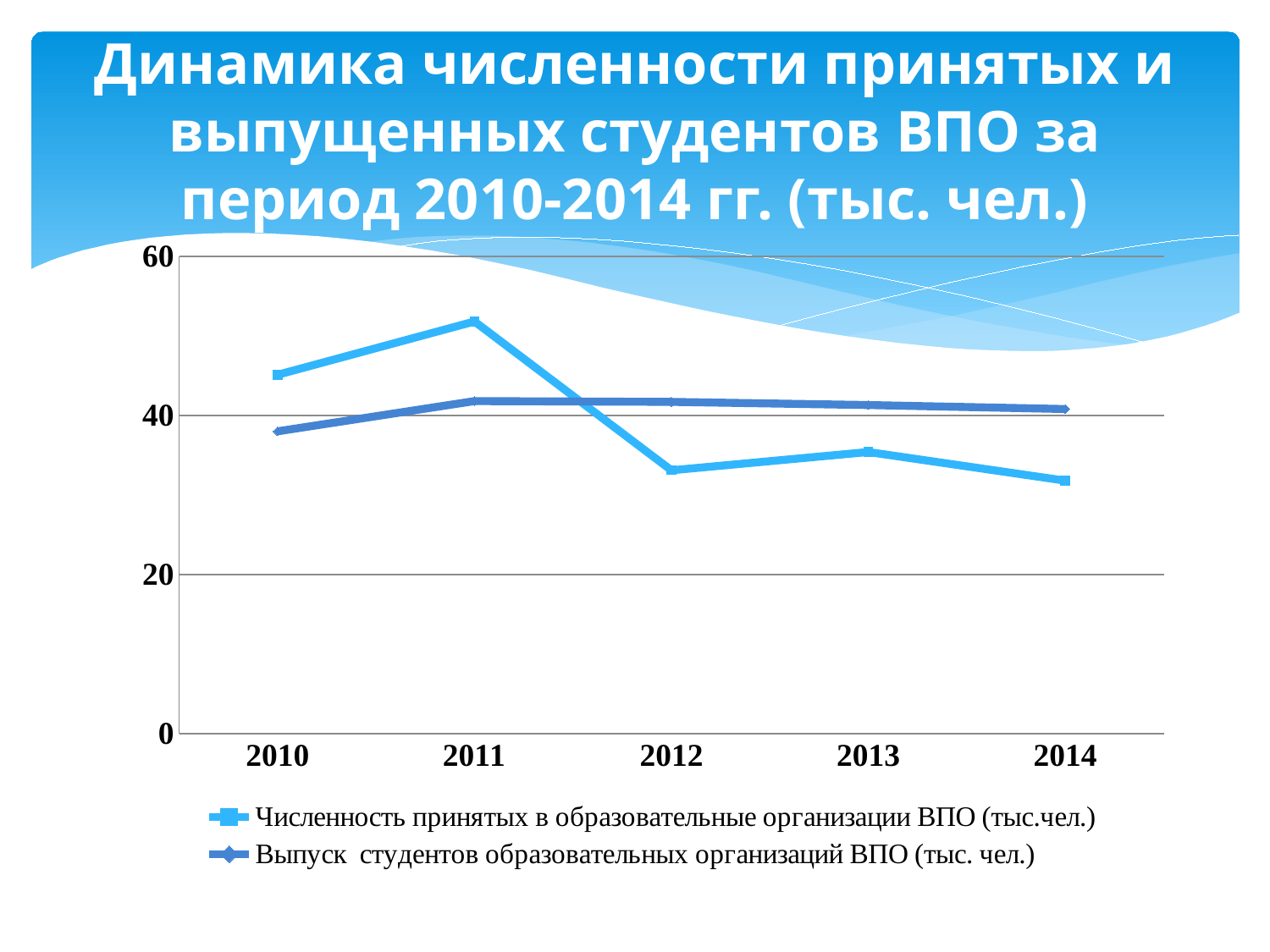
Is the value for graduated students in 2010 greater or less than 40? less Is the value for admitted students in 2011 greater or less than 40? greater What kind of chart is shown on the slide? line chart Does the number of admitted students rise or fall from 2011 to 2014? fall How many series does the legend list? 2 In which year is the number of admitted students (Численность принятых) highest? 2011 In 2013, which is larger: the number of admitted students or the number of graduated students? graduated students In 2010, which is larger: the number of admitted students or the number of graduated students? admitted students In which year is the number of graduated students (Выпуск студентов) lowest? 2010 Is the value for admitted students in 2012 greater or less than 40? less How many years are plotted along the x axis? 5